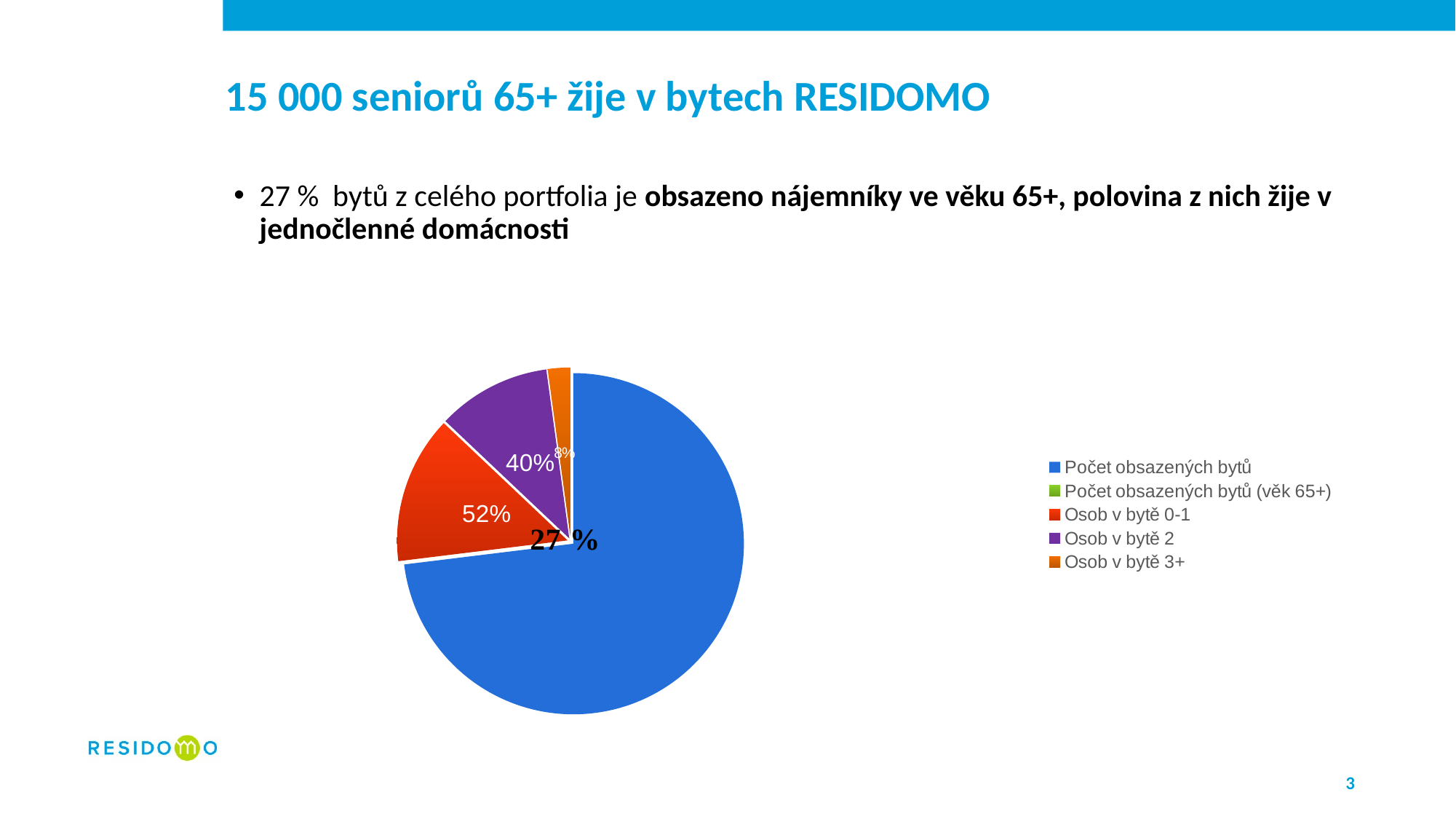
What is the difference between the Osob v bytě 0-1 slice and the Osob v bytě 2 slice? 12% What percentage is shown for the Osob v bytě 3+ slice? 8% Among the slices with printed percentage labels, which is the smallest? Osob v bytě 3+ How many entries does the chart legend list? 5 What colour is the Osob v bytě 0-1 slice? red Which legend category has the largest slice of the pie? Počet obsazených bytů Which slice is larger, Osob v bytě 2 or Osob v bytě 3+? Osob v bytě 2 What colour is the Osob v bytě 2 slice? purple Which slice is larger, Osob v bytě 0-1 or Osob v bytě 2? Osob v bytě 0-1 What percentage is shown for the Osob v bytě 2 slice? 40% What kind of chart is shown on the slide? pie chart What percentage is shown for the Osob v bytě 0-1 slice? 52%